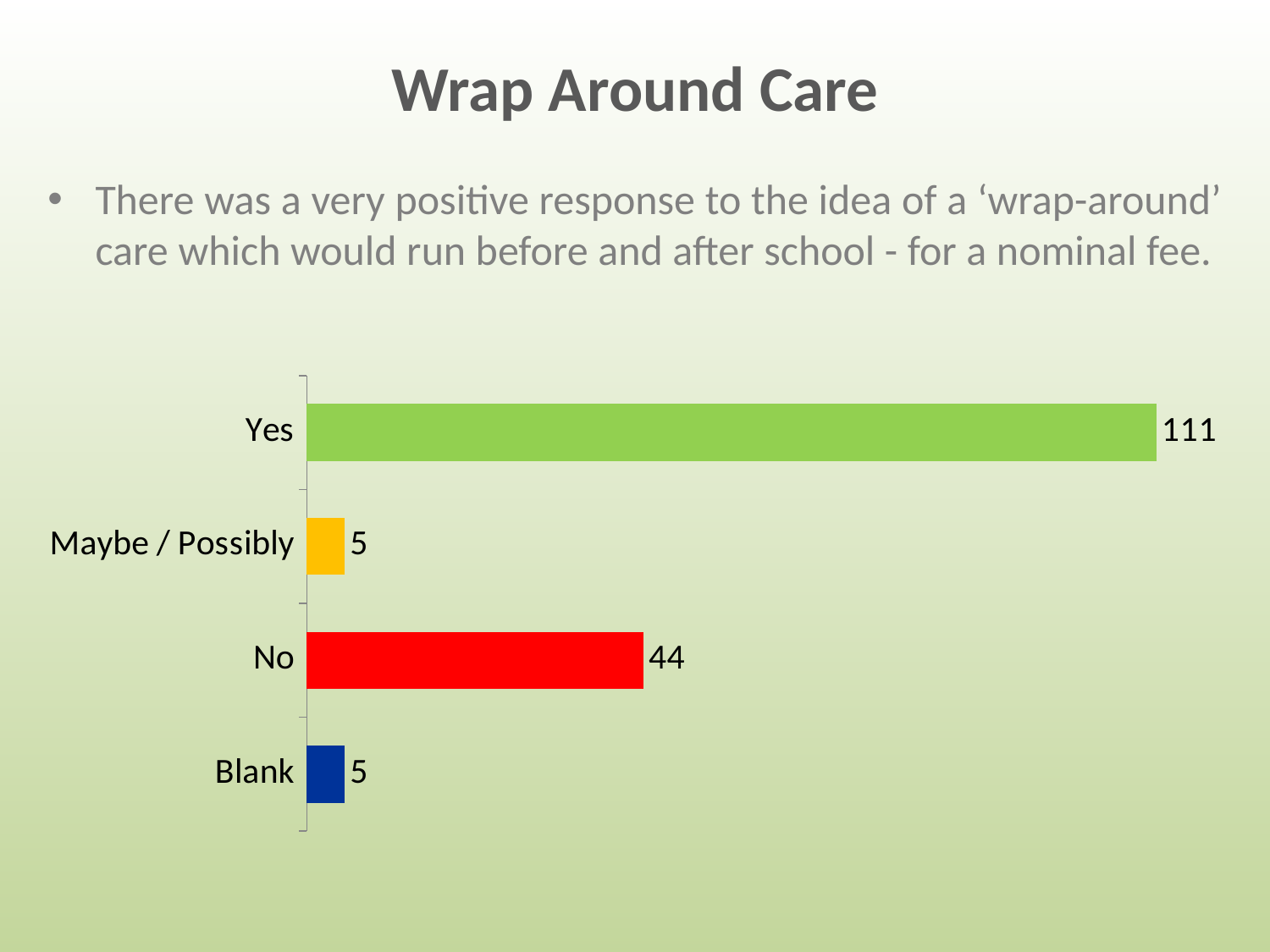
How many categories are shown in the chart? 4 What kind of chart is shown on the slide? Bar chart What is the difference between the values for Yes and No? 67 Which is larger, the value for No or the value for Maybe / Possibly? No What is the value for Maybe / Possibly? 5 What is the difference between the values for No and Blank? 39 What is the value for Blank? 5 What is the value for Yes? 111 What is the value for No? 44 What colour is the bar for Yes? Green What colour is the bar for No? Red Which category has the highest value? Yes